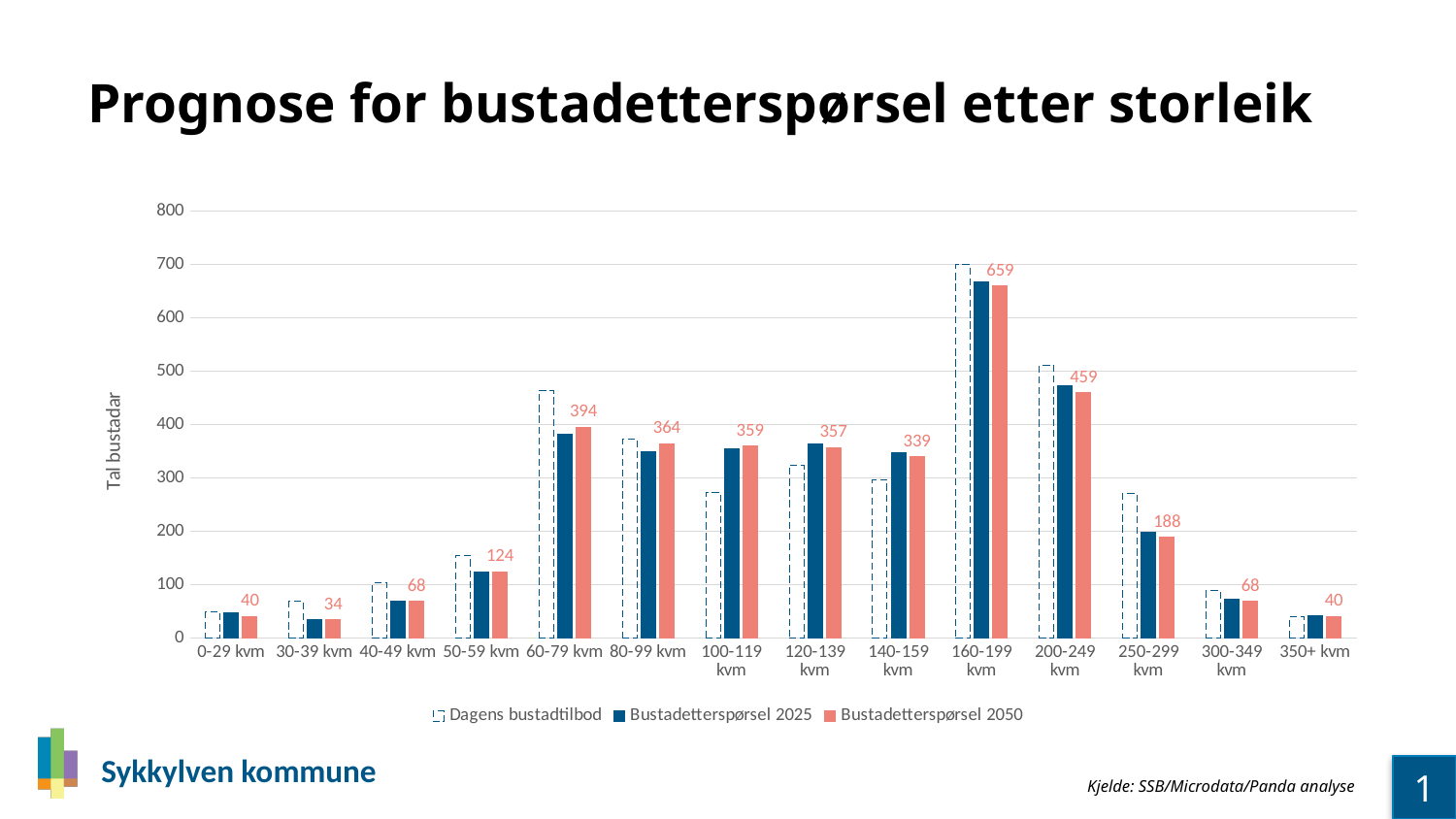
What is the difference between the Bustadetterspørsel 2050 values for 160-199 kvm and 200-249 kvm? 200 What is the Bustadetterspørsel 2050 value for 250-299 kvm? 188 What kind of chart is shown on the slide? Bar chart What is the Bustadetterspørsel 2050 value for 60-79 kvm? 394 How many size categories are shown on the x axis? 14 Is the Dagens bustadtilbod value for 100-119 kvm greater or less than 300? less Which size category has the highest Bustadetterspørsel 2050 value? 160-199 kvm Which is larger for Bustadetterspørsel 2050: 80-99 kvm or 100-119 kvm? 80-99 kvm Is the Dagens bustadtilbod value for 160-199 kvm greater or less than 600? greater What is the Bustadetterspørsel 2050 value for 160-199 kvm? 659 Which size category has the lowest Bustadetterspørsel 2050 value? 30-39 kvm How many series does the legend list? 3